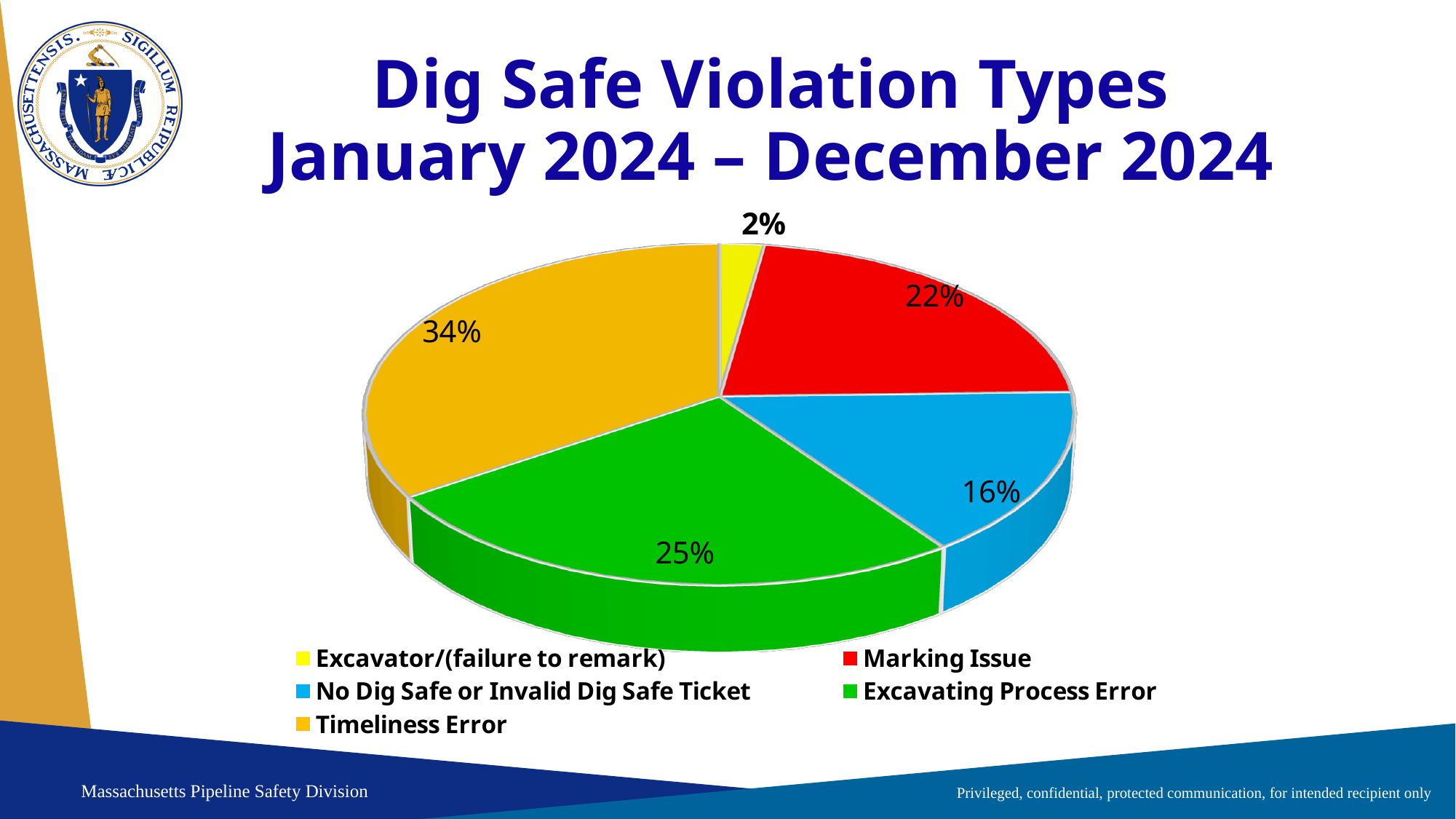
What share of Dig Safe violations is Marking Issue? 22% What colour represents Marking Issue in the pie chart? Red What share of Dig Safe violations is No Dig Safe or Invalid Dig Safe Ticket? 16% What type of chart is shown on the slide? Pie chart How many violation types are shown in the pie chart? 5 Which has a larger share, Excavating Process Error or No Dig Safe or Invalid Dig Safe Ticket? Excavating Process Error Which violation type has the smallest share of the pie? Excavator/(failure to remark) Which violation type has the largest share of the pie? Timeliness Error What share of Dig Safe violations is Timeliness Error? 34% What is the difference in percentage points between Timeliness Error and Marking Issue? 12